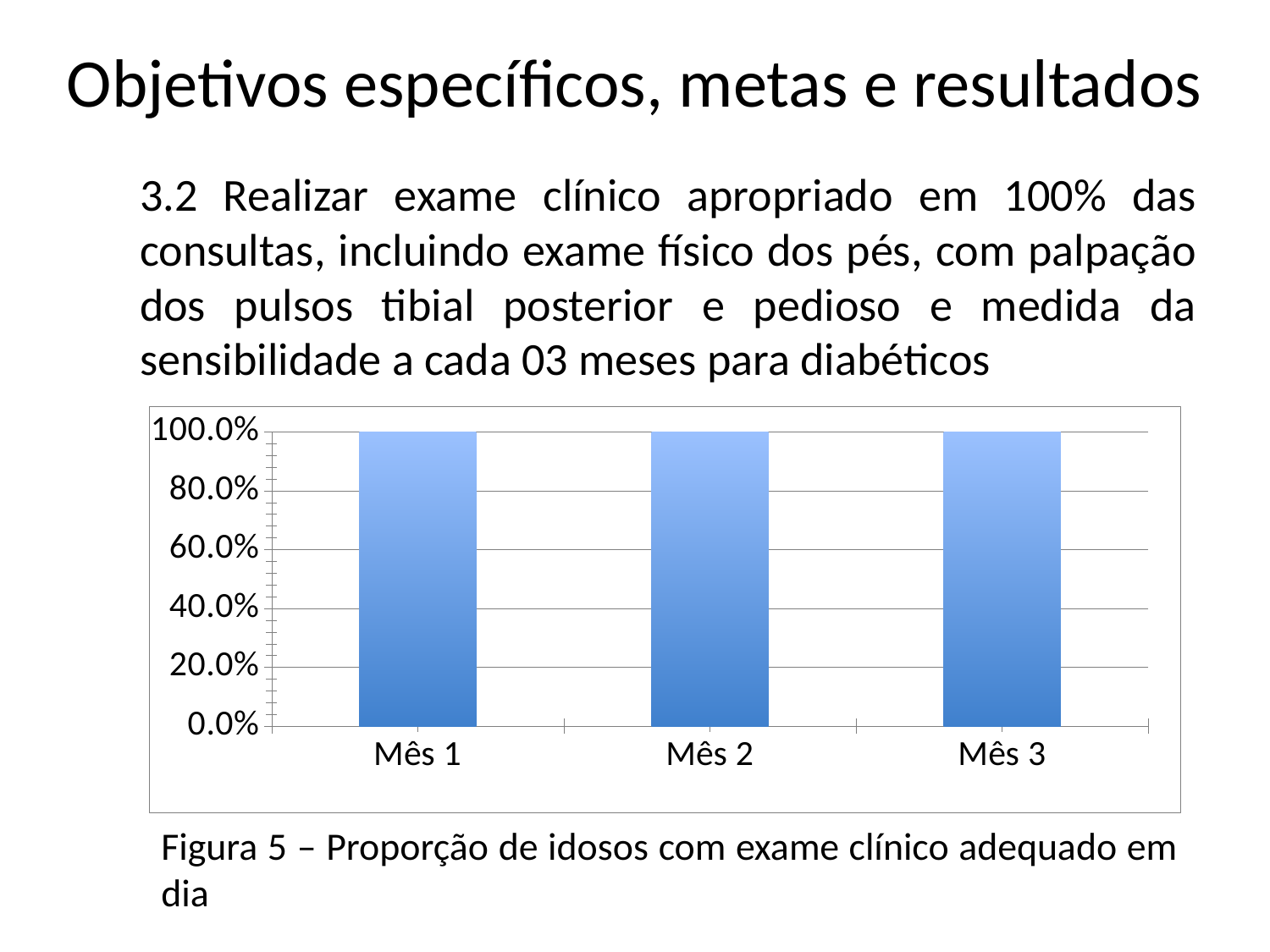
Is the value for Mês 3 greater or less than 60.0%? greater Is the value for Mês 1 greater or less than 80.0%? greater What is the value for Mês 1 in the chart? 100.0% What type of chart is shown on the slide? bar chart How many categories (months) are shown on the x axis of the chart? 3 What is the value for Mês 3 in the chart? 100.0% Do the values rise, fall, or stay the same from Mês 1 to Mês 3? stay the same What is the highest value shown on the y axis of the chart? 100.0% What is the difference between the values for Mês 1 and Mês 2? 0.0% What is the caption (figure title) given below the chart? Figura 5 – Proporção de idosos com exame clínico adequado em dia What is the value for Mês 2 in the chart? 100.0%